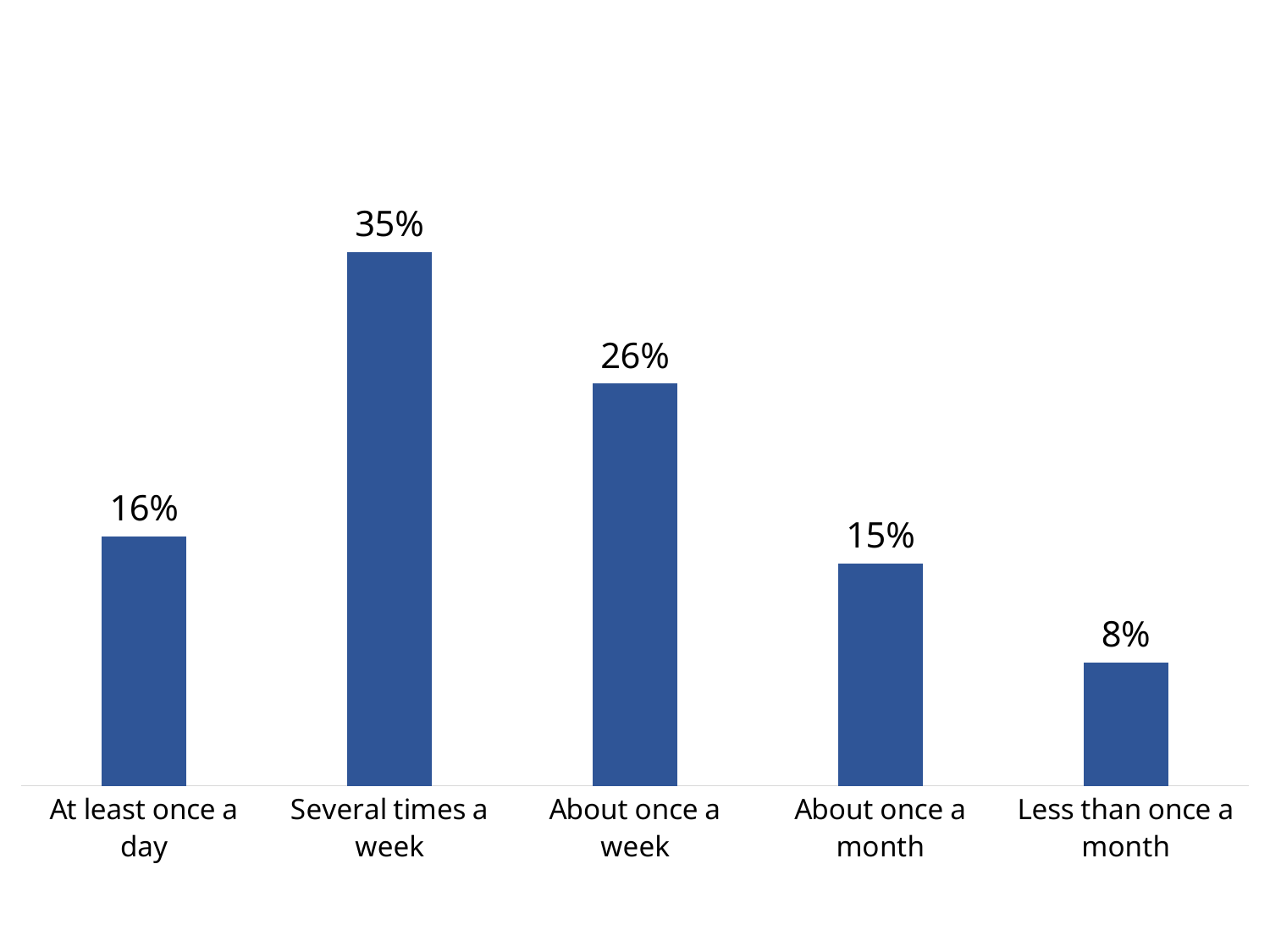
What is the difference between the values for "At least once a day" and "Less than once a month"? 8% What is the difference between the values for "Several times a week" and "About once a week"? 9% How many categories are shown on the chart? 5 Which category has the lowest value? Less than once a month Which is larger, the value for "About once a week" or the value for "About once a month"? About once a week What is the value for "About once a month"? 15% What is the value for "At least once a day"? 16% What is the value for "Less than once a month"? 8% What is the value for "Several times a week"? 35% What kind of chart is shown on the slide? Bar chart Which category has the highest value? Several times a week What colour are the bars in the chart? Blue